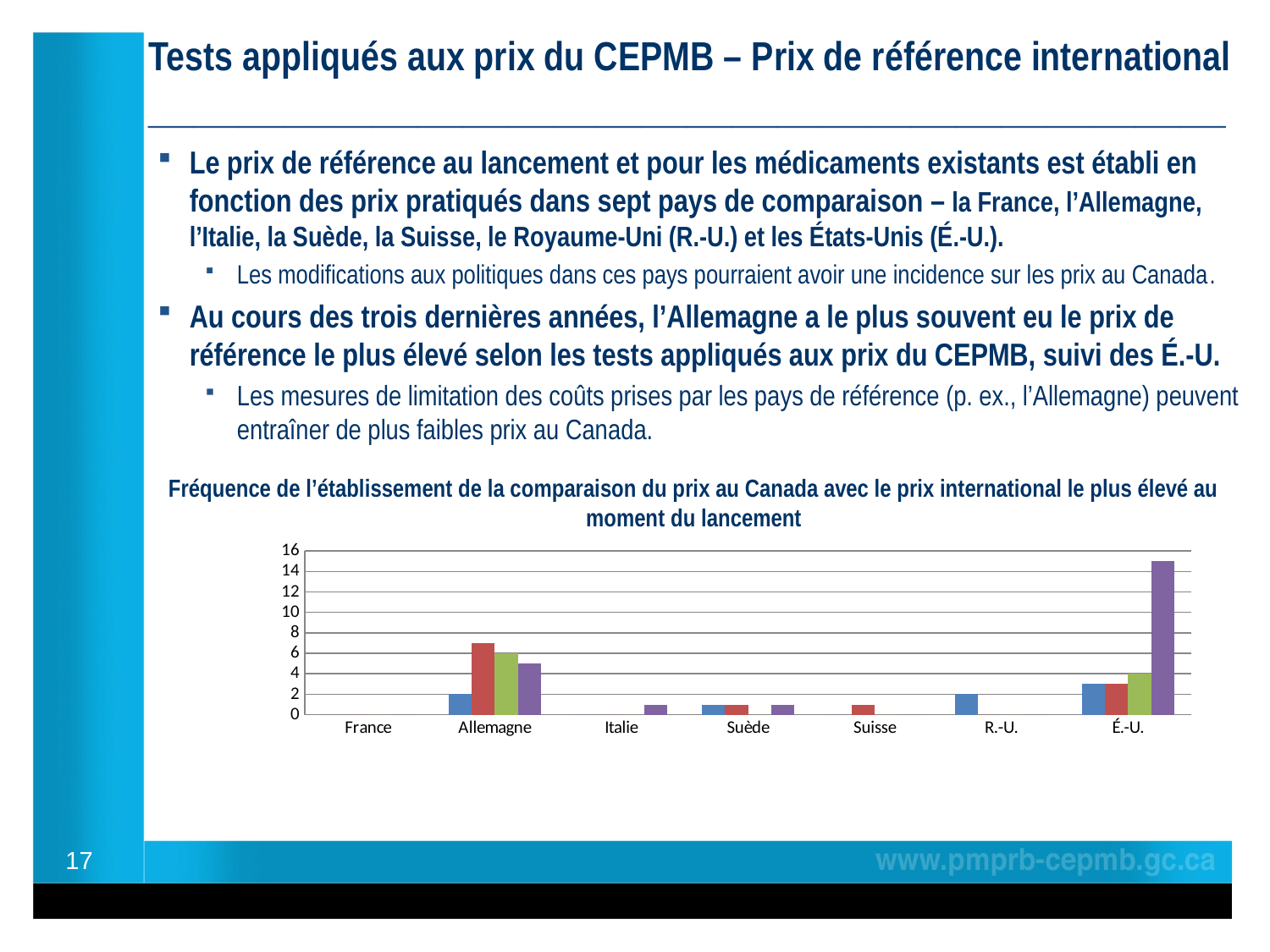
How many countries are listed along the x axis of the chart? 7 Which country has the tallest bar in the chart? É.-U. Is the blue bar for R.-U. greater or less than 4? less How many different bar colours are used in the chart? 4 Is the tallest (purple) bar for É.-U. greater or less than 14? greater Which country has the larger tallest bar, Suisse or R.-U.? R.-U. Is the tallest (red) bar for Allemagne greater or less than 6? greater Which country has the larger tallest bar, Allemagne or É.-U.? É.-U. What kind of chart is shown on the slide? bar chart What is the highest value shown on the chart's y axis? 16 Which country shows no bars at all in the chart? France